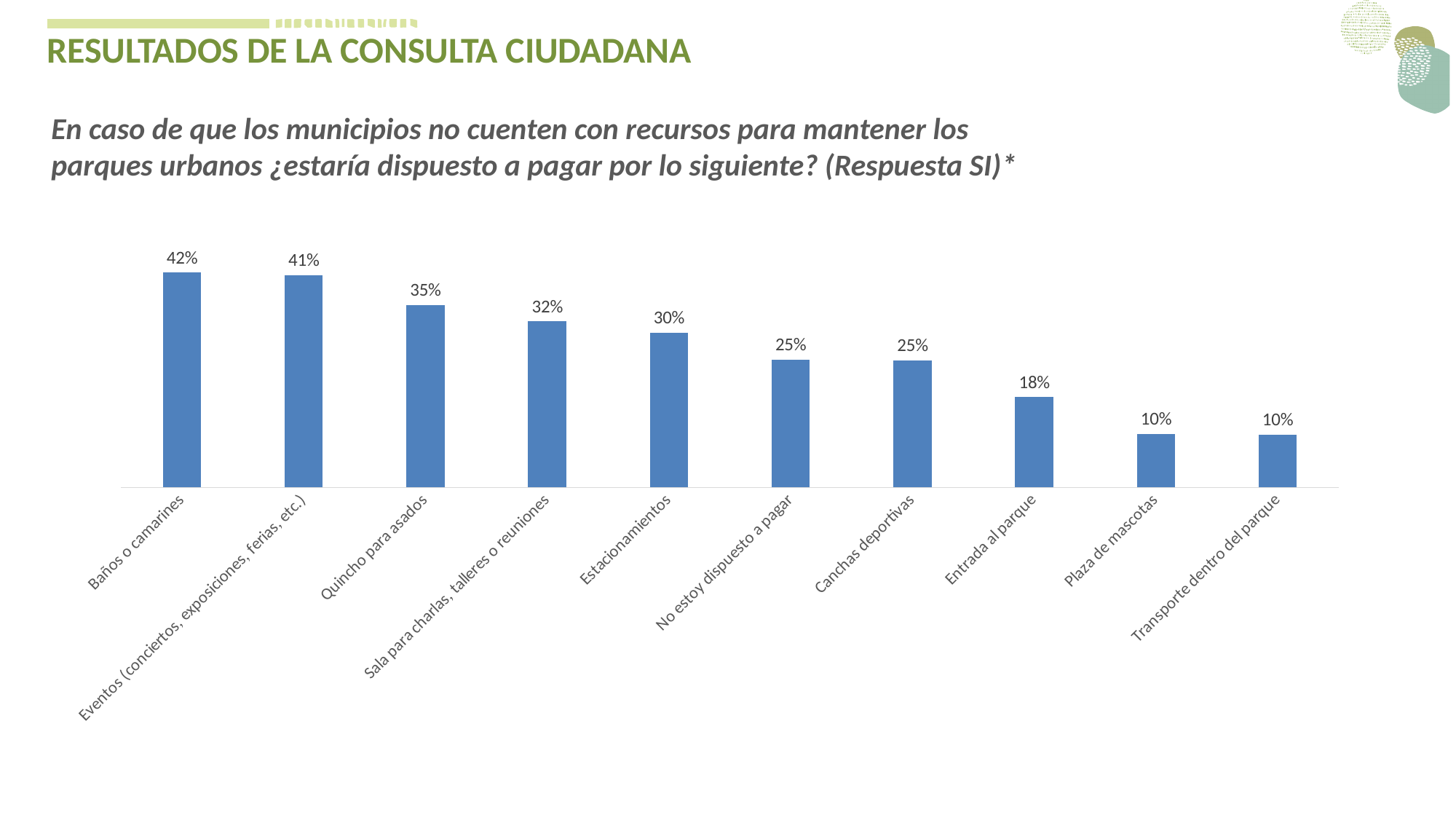
Do the values rise or fall from left to right along the x axis? Fall What is the lowest value shown in the chart? 10% What kind of chart is shown on the slide? Bar chart Which is larger, the value for Sala para charlas, talleres o reuniones or the value for Estacionamientos? Sala para charlas, talleres o reuniones What is the value for Quincho para asados? 35% What is the difference between the values for Quincho para asados and Canchas deportivas? 10% How many categories are shown in the chart? 10 What is the value for Baños o camarines? 42% What is the value for Estacionamientos? 30% What is the difference between the values for Baños o camarines and Transporte dentro del parque? 32% What is the value for Entrada al parque? 18% Which category has the highest value? Baños o camarines